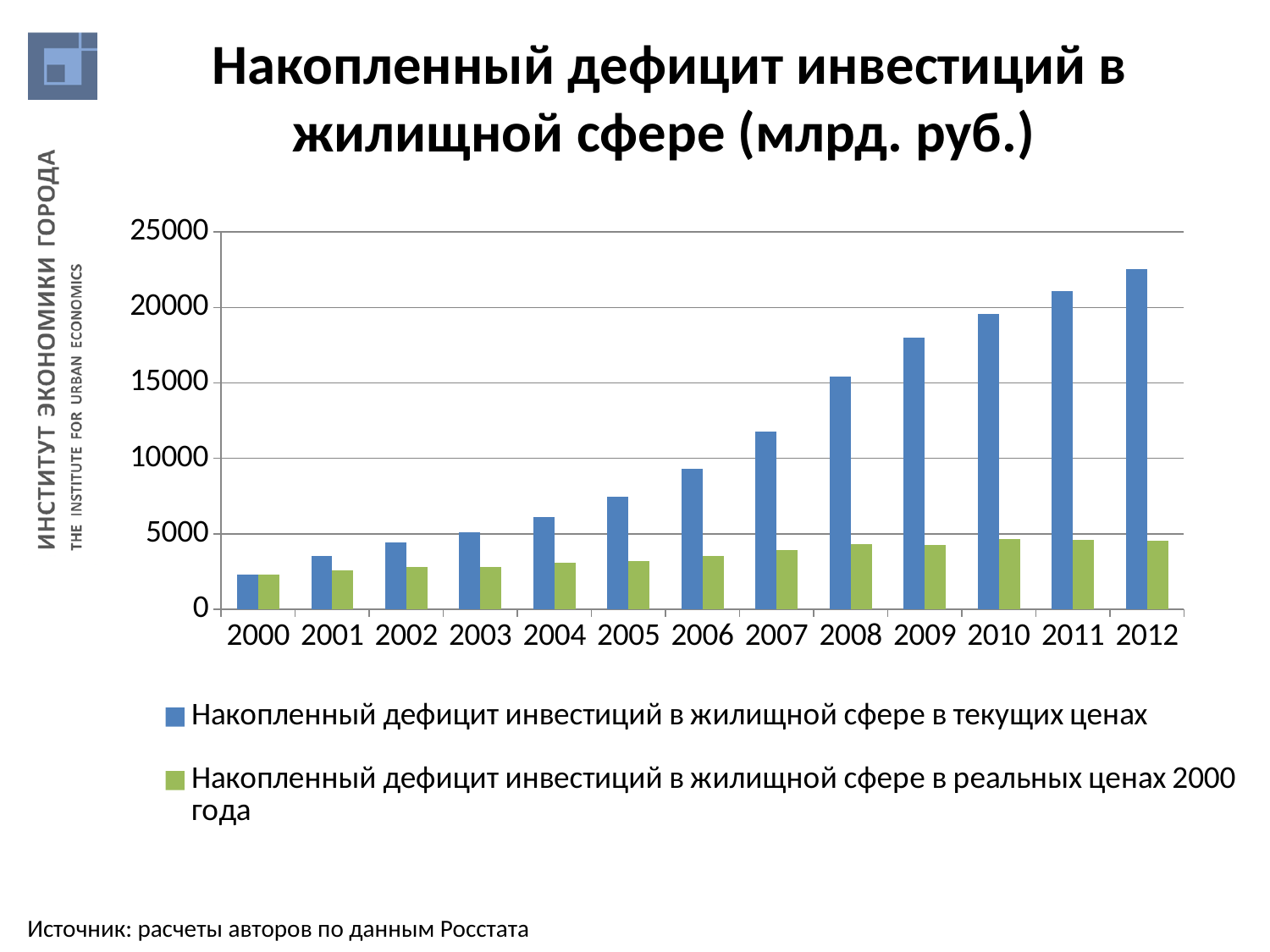
Which year has the lowest value for the accumulated investment deficit in current prices (в текущих ценах)? 2000 Is the value for 2006 in current prices (в текущих ценах) greater or less than 10000? less What colour are the bars for the series in real 2000 prices (в реальных ценах 2000 года)? green How many years are shown on the x axis? 13 Does the accumulated investment deficit in current prices (в текущих ценах) rise or fall from 2000 to 2012? rise Is the value for 2007 in current prices (в текущих ценах) greater or less than 10000? greater In 2012, which series has the larger value: current prices (в текущих ценах) or real 2000 prices (в реальных ценах 2000 года)? current prices (в текущих ценах) Is the value for 2012 in real 2000 prices (в реальных ценах 2000 года) greater or less than 5000? less How many series does the legend list? 2 What kind of chart is shown on the slide? bar chart Which year has the highest value for the accumulated investment deficit in current prices (Накопленный дефицит инвестиций в жилищной сфере в текущих ценах)? 2012